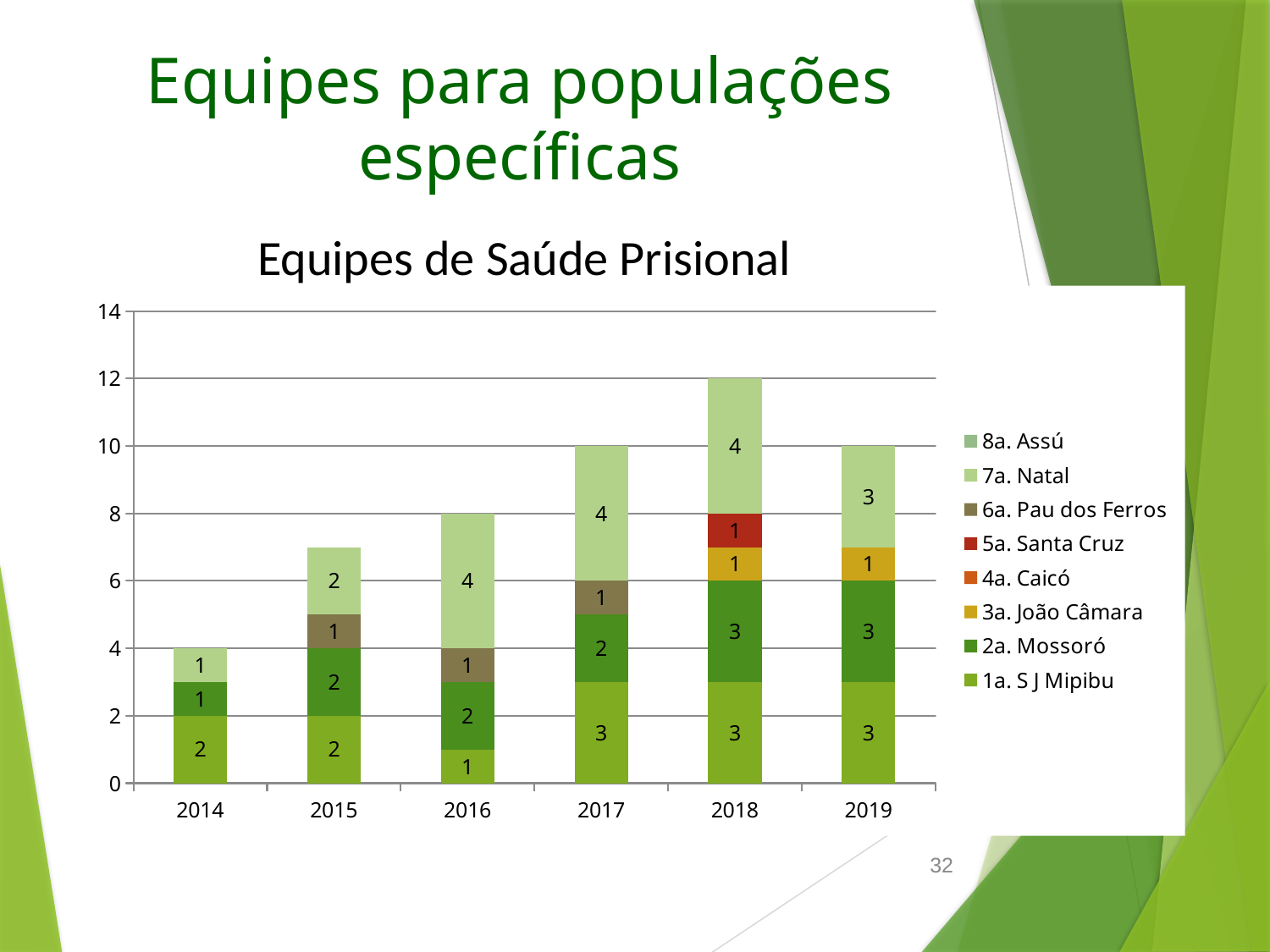
What kind of chart is shown on the slide? Stacked bar chart What is the value for 7a. Natal in 2016? 4 What is the value for 1a. S J Mipibu in 2014? 2 Is the value for 2a. Mossoró larger in 2017 or in 2018? 2018 How many years are shown on the x axis? 6 How many series does the legend list? 8 What is the value for 5a. Santa Cruz in 2018? 1 Which year has the lowest total number of teams? 2014 What is the total height of the stacked bar for 2015? 7 Which year has the highest total number of teams? 2018 What is the difference between the 7a. Natal value in 2018 and in 2019? 1 What is the total height of the stacked bar for 2018? 12